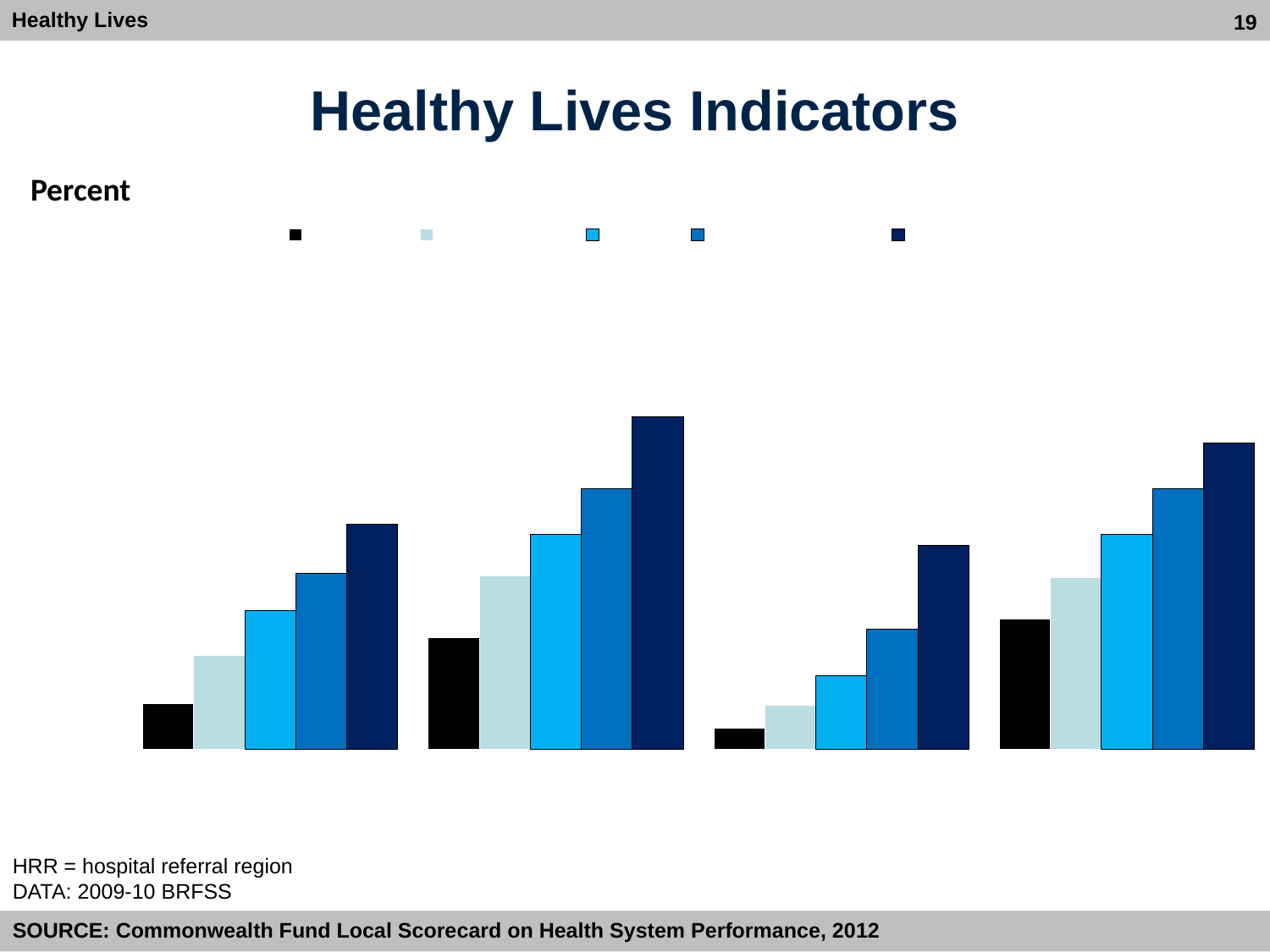
Within each group of bars, do the values rise or fall from left to right? rise What is the title of the chart on the slide? Healthy Lives Indicators What kind of chart is shown on the slide? bar chart Which colour bar is the shortest in every group? black Counting from the left, which group contains the shortest bar in the chart? third How many series markers does the legend show? 5 What unit label is shown above the chart's vertical axis? Percent How many groups of bars are plotted in the chart? 4 Is the black bar in the first group from the left taller or shorter than the black bar in the fourth group? shorter Counting from the left, which group contains the tallest bar in the chart? second Which colour bar is the tallest in every group? dark navy